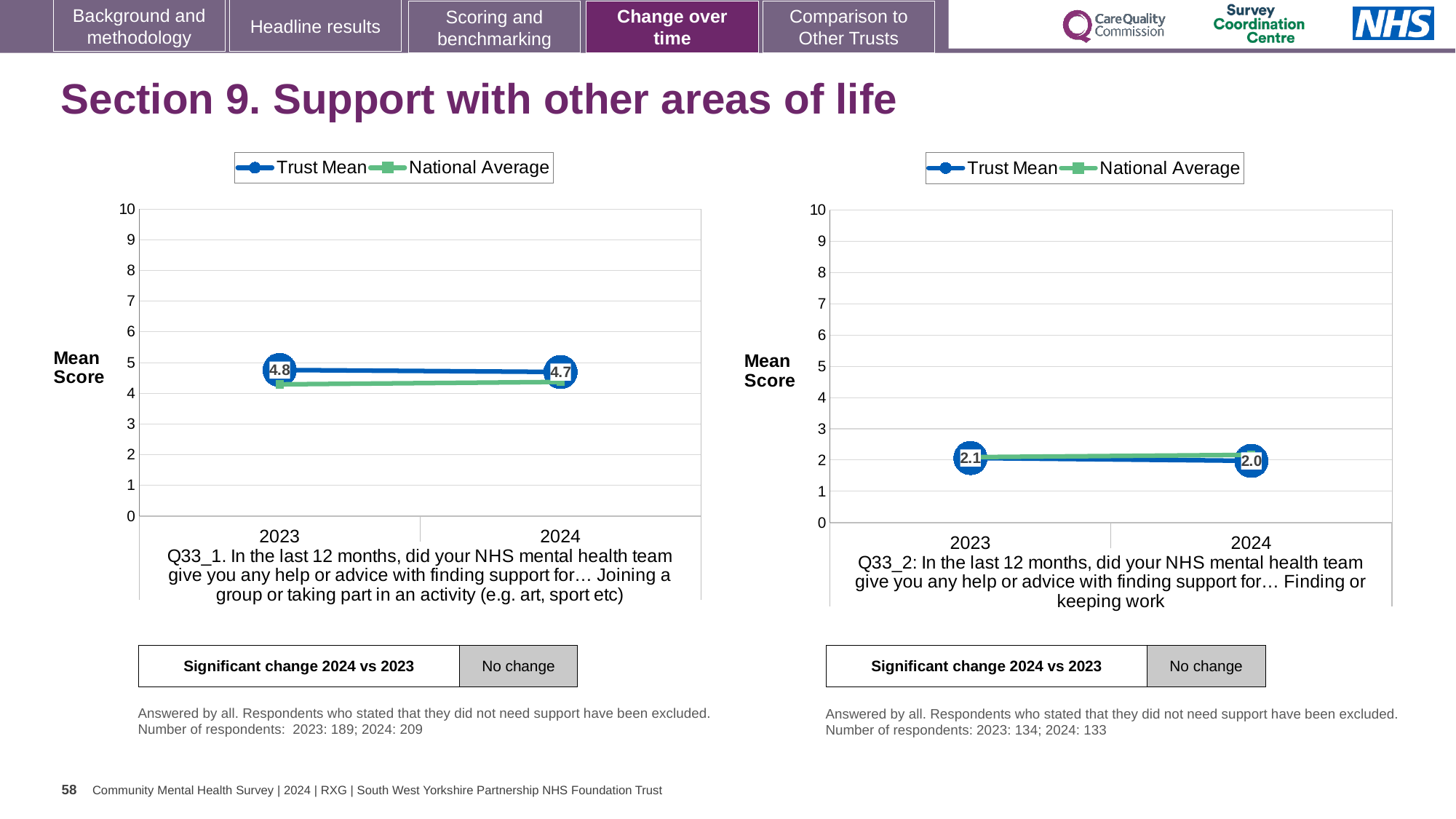
In the left chart (Q33_1), what is the Trust Mean for 2023? 4.8 In the right chart (Q33_2), what is the Trust Mean for 2023? 2.1 In the left chart (Q33_1), which is higher in 2023, the Trust Mean or the National Average? Trust Mean In the right chart (Q33_2), what is the difference between the Trust Mean in 2023 and in 2024? 0.1 In the left chart (Q33_1), does the Trust Mean rise or fall from 2023 to 2024? fall In the right chart (Q33_2), is the National Average for 2024 greater or less than 3? less In the left chart (Q33_1), what is the Trust Mean for 2024? 4.7 How many series does the legend of the right chart (Q33_2) list? 2 In the left chart (Q33_1), is the National Average for 2023 greater or less than 5? less In the left chart (Q33_1), by how much did the Trust Mean change from 2023 to 2024? 0.1 In the right chart (Q33_2), what is the Trust Mean for 2024? 2.0 What type of chart is the left chart (Q33_1)? line chart